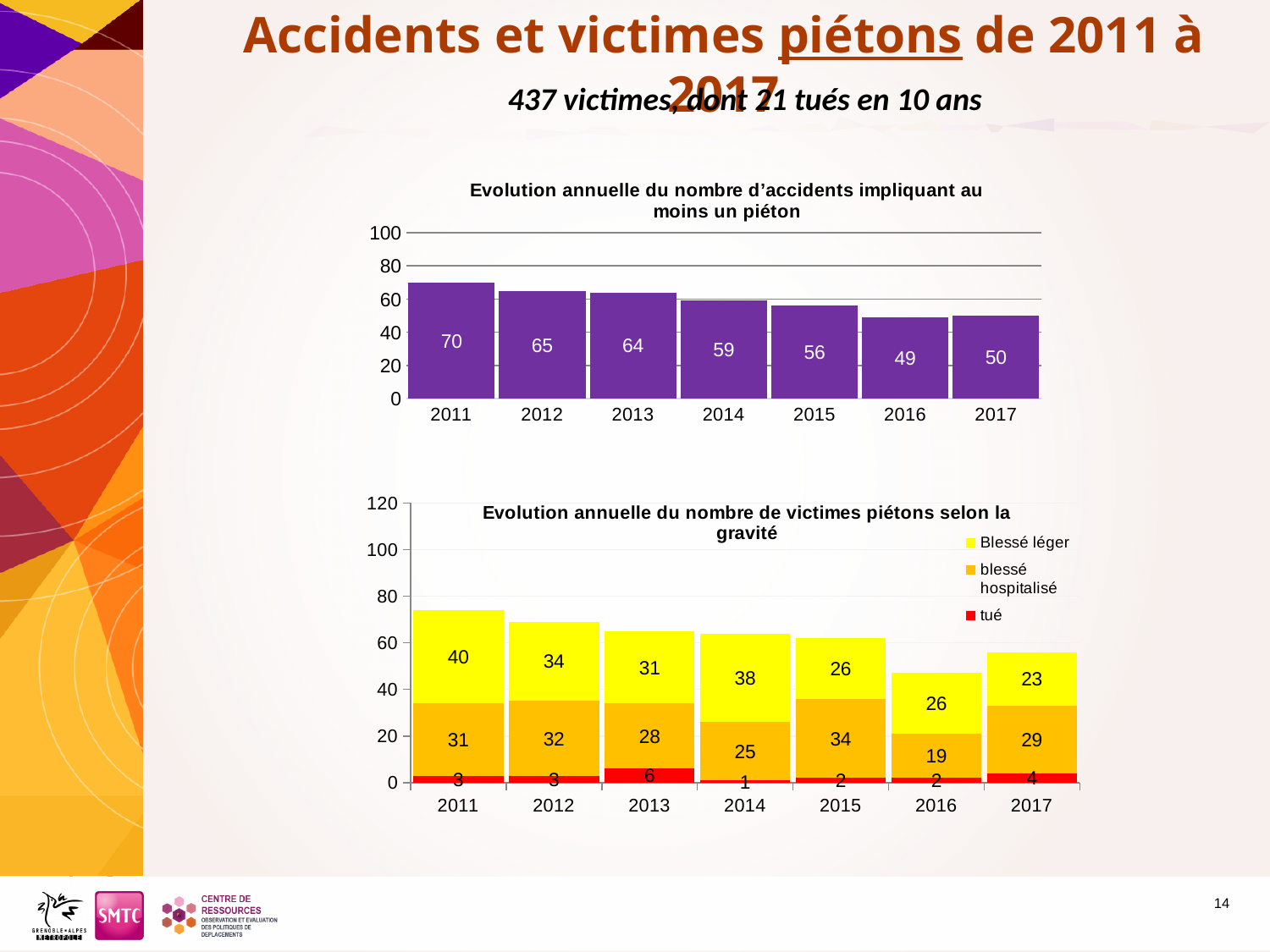
What kind of chart is the top chart (accidents impliquant au moins un piéton)? bar chart In the bottom chart (victimes piétons selon la gravité), which year has the highest value for 'tué'? 2013 In the top chart (accidents impliquant au moins un piéton), do the values generally rise or fall from 2011 to 2016? fall In the bottom chart (victimes piétons selon la gravité), how many series does the legend list? 3 In the bottom chart (victimes piétons selon la gravité), what is the value for 'tué' in 2013? 6 In the bottom chart (victimes piétons selon la gravité), what is the total of the stacked bar for 2011? 74 In the bottom chart (victimes piétons selon la gravité), which is larger in 2015: 'Blessé léger' or 'blessé hospitalisé'? blessé hospitalisé In the top chart (accidents impliquant au moins un piéton), how many years are shown on the x axis? 7 In the top chart (accidents impliquant au moins un piéton), what is the value for 2011? 70 In the top chart (accidents impliquant au moins un piéton), which year has the lowest value? 2016 In the top chart (accidents impliquant au moins un piéton), what is the difference between the values for 2011 and 2017? 20 In the bottom chart (victimes piétons selon la gravité), what is the value for 'Blessé léger' in 2014? 38